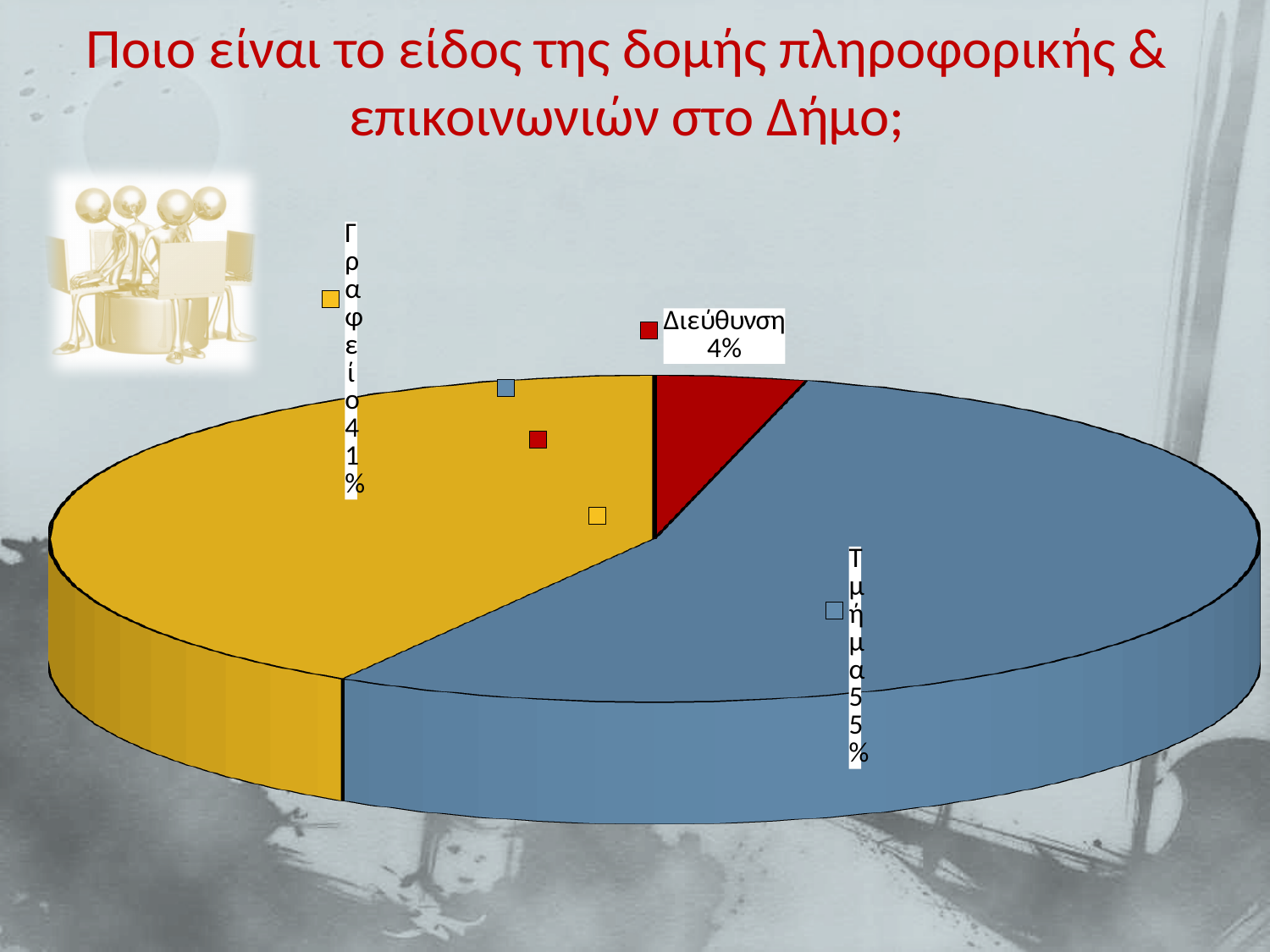
What colour is the Διεύθυνση slice? red What colour is the Τμήμα slice? blue Which is larger, the share for Γραφείο or the share for Διεύθυνση? Γραφείο What percentage does the Διεύθυνση slice represent? 4% What kind of chart is shown on the slide? pie chart Which category has the smallest share of the pie? Διεύθυνση What percentage does the Τμήμα slice represent? 55% Which category has the largest share of the pie? Τμήμα What is the difference in percentage points between Τμήμα and Γραφείο? 14 What percentage does the Γραφείο slice represent? 41% What is the difference in percentage points between Γραφείο and Διεύθυνση? 37 How many slices does the pie chart have? 3